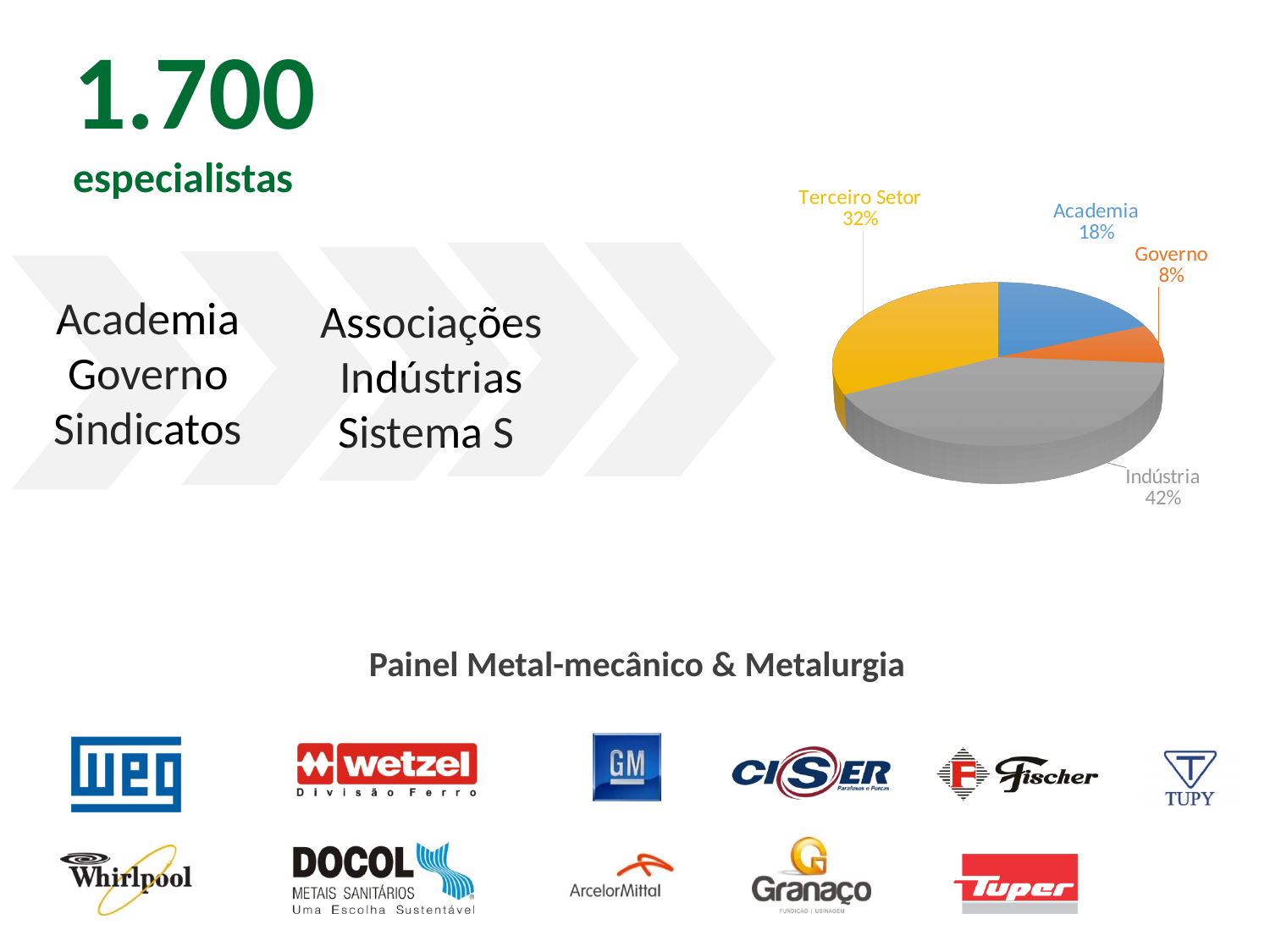
Which category has the largest slice of the pie? Indústria What share of the pie does Indústria represent? 42% What is the value shown for Academia? 18% Which is larger, the Academia share or the Governo share? Academia What colour is the Indústria slice of the pie? grey What is the value shown for Governo? 8% What kind of chart is shown on the slide? pie chart Which category has the smallest slice of the pie? Governo How many slices does the pie chart have? 4 What is the difference between the Academia and Governo shares? 10% What is the value shown for Terceiro Setor? 32% What is the difference between the Indústria and Terceiro Setor shares? 10%